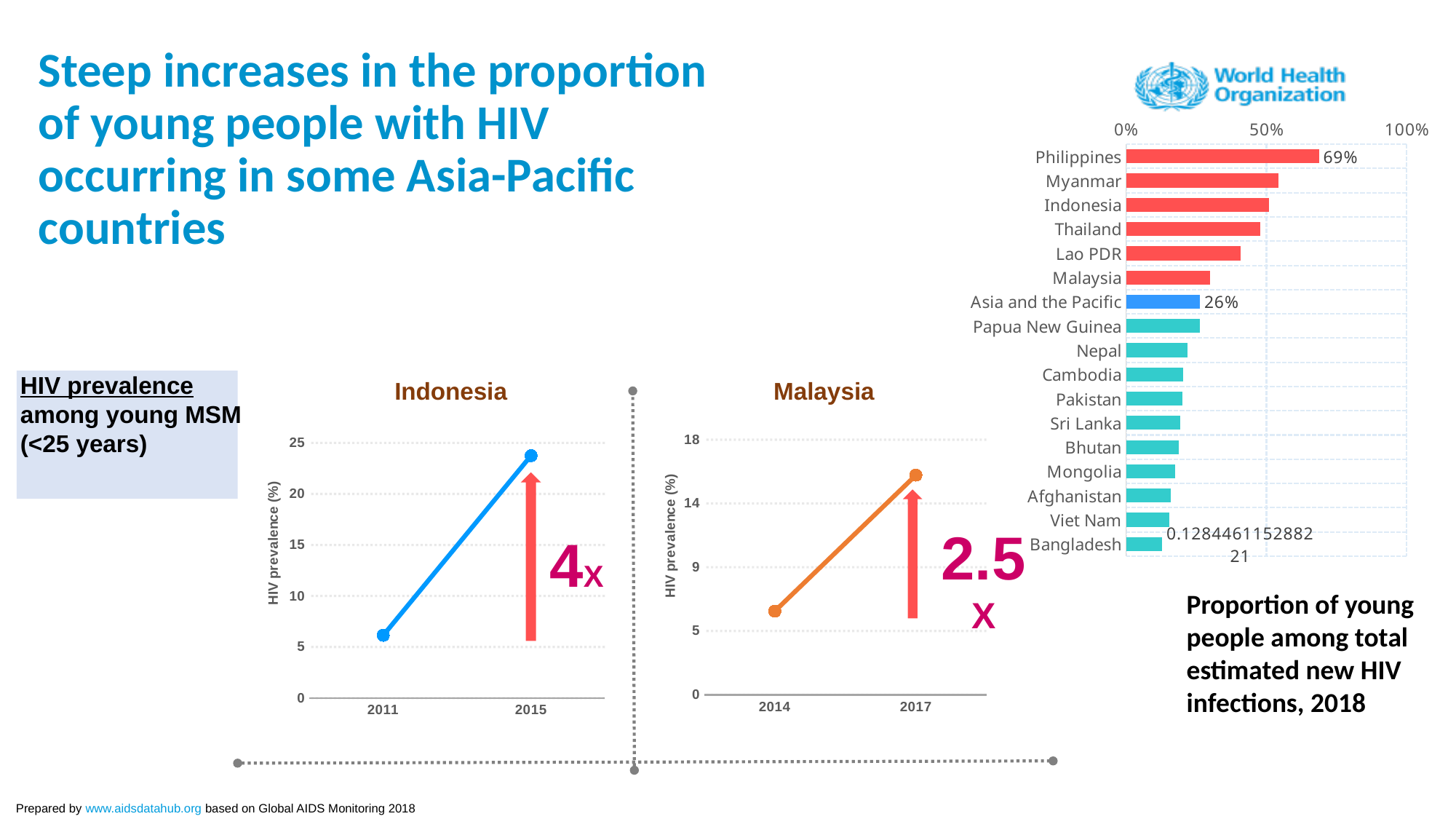
In the bar chart titled 'Proportion of young people among total estimated new HIV infections, 2018', is the value for Myanmar greater or less than 50%? greater In the Malaysia chart, is the HIV prevalence value for 2017 greater or less than 14? greater In the bar chart titled 'Proportion of young people among total estimated new HIV infections, 2018', which country has the highest value? Philippines What kind of chart is the chart titled 'Proportion of young people among total estimated new HIV infections, 2018'? bar chart In the Indonesia chart, is the HIV prevalence value for 2011 greater or less than 10? less In the bar chart titled 'Proportion of young people among total estimated new HIV infections, 2018', which country has the lowest value? Bangladesh In the bar chart titled 'Proportion of young people among total estimated new HIV infections, 2018', what is the value for Asia and the Pacific? 26% In the bar chart titled 'Proportion of young people among total estimated new HIV infections, 2018', which is larger, the value for Thailand or the value for Nepal? Thailand In the bar chart titled 'Proportion of young people among total estimated new HIV infections, 2018', how many categories are shown? 17 In the Indonesia chart, does HIV prevalence rise or fall from 2011 to 2015? rise In the bar chart titled 'Proportion of young people among total estimated new HIV infections, 2018', what is the value for the Philippines? 69%